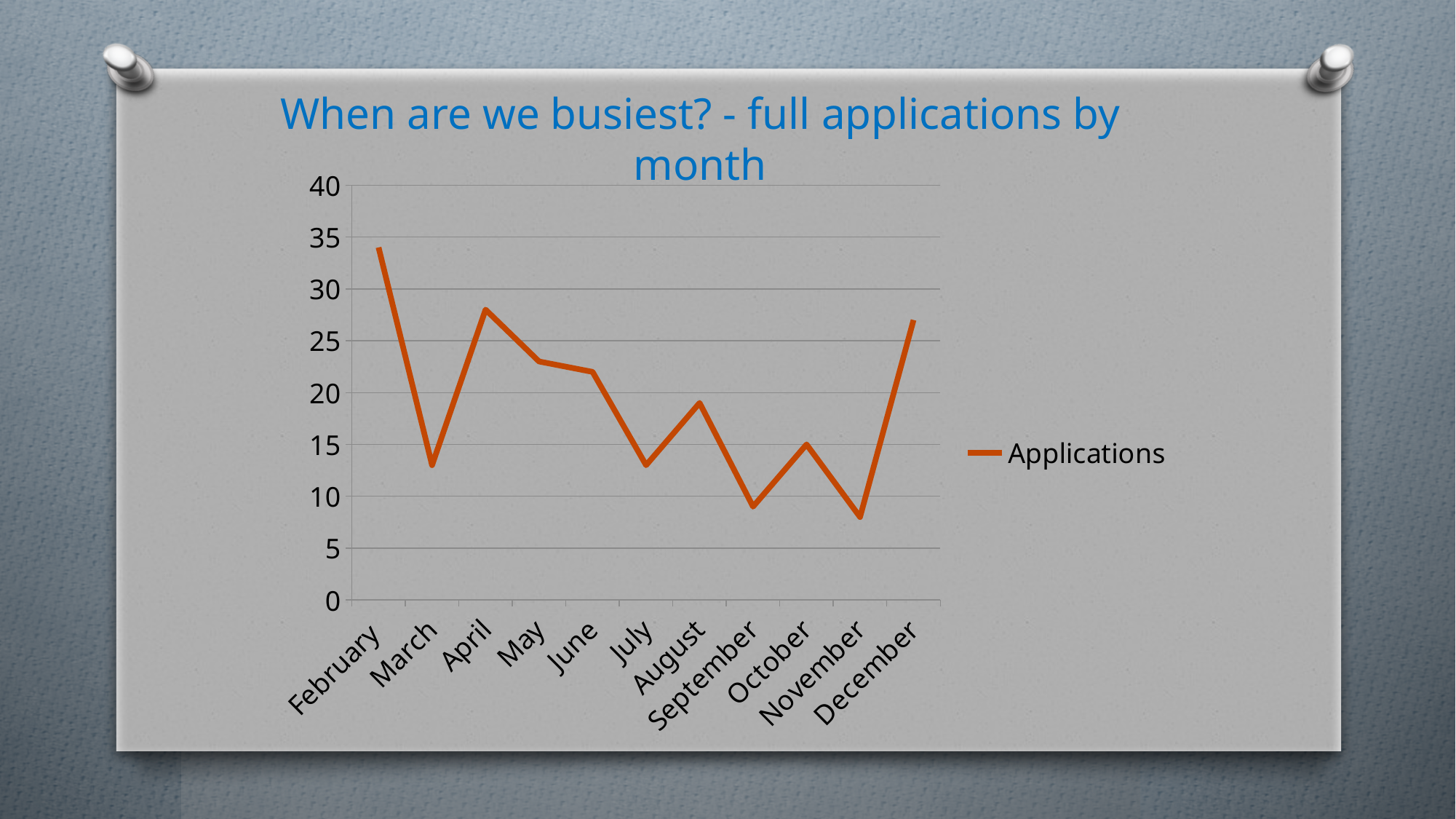
Which month has the highest number of applications? February How many months are plotted on the x axis? 11 What kind of chart is shown on the slide? line chart Is the value for March greater or less than 15? less How many series does the legend list? 1 Which has more applications, May or August? May Is the value for September greater or less than 10? less What is the title of the chart? When are we busiest? - full applications by month Is the value for December greater or less than 25? greater Do applications rise or fall from February to March? fall What is the name of the series shown in the legend? Applications